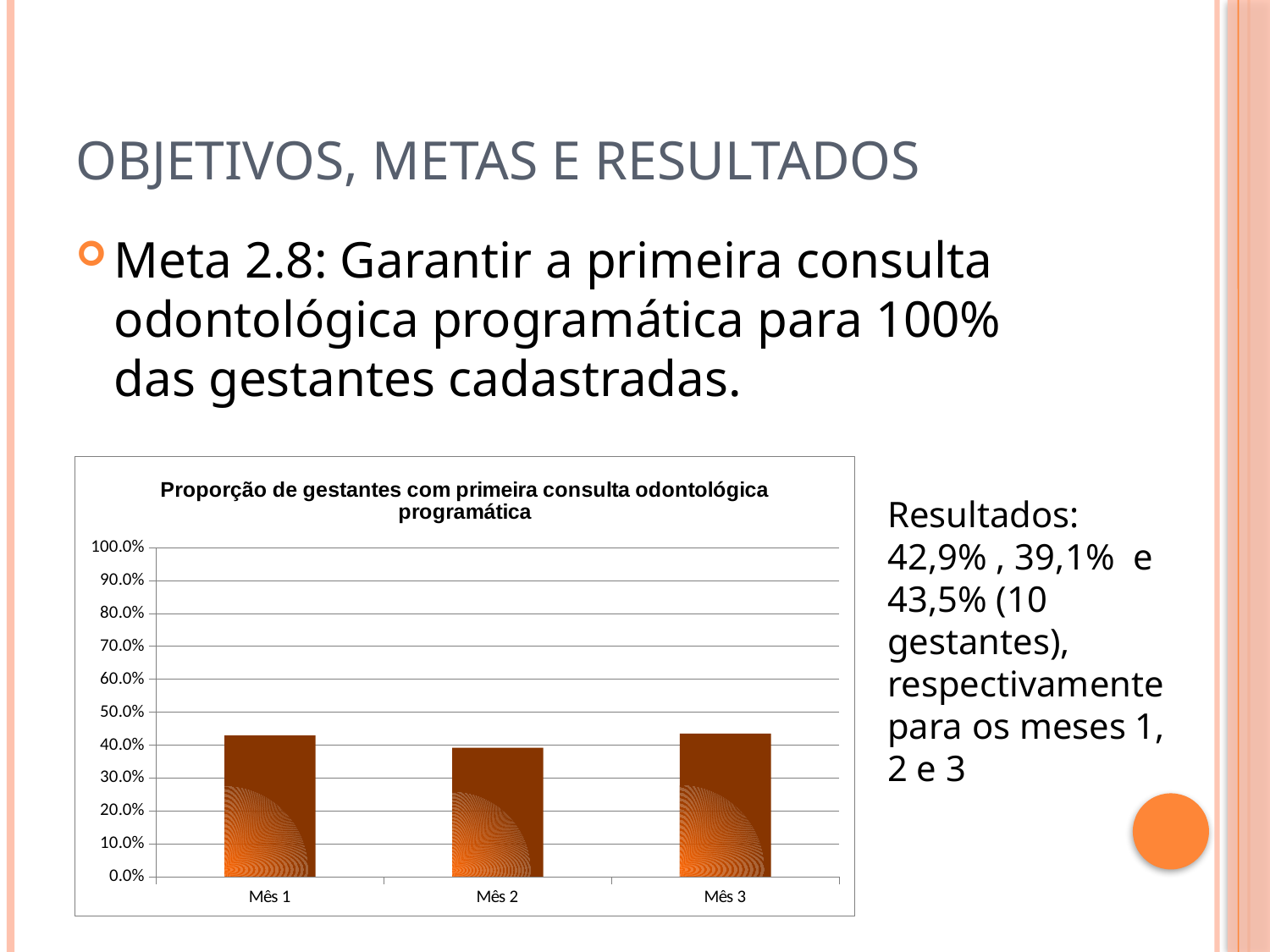
What is the difference between the values for Mês 3 and Mês 2? 4,4% According to the slide, what is the value for Mês 1? 42,9% Which is larger, the value for Mês 1 or the value for Mês 2? Mês 1 Which month has the highest value in the chart? Mês 3 According to the slide, what is the value for Mês 2? 39,1% How many categories (months) are shown on the x axis of the chart? 3 According to the slide, what is the value for Mês 3? 43,5% Is the value for Mês 2 greater or less than 40.0%? less Which month has the lowest bar in the chart? Mês 2 What is the title of the chart? Proporção de gestantes com primeira consulta odontológica programática Is the value for Mês 3 greater or less than 40.0%? greater What kind of chart is shown on the slide? bar chart